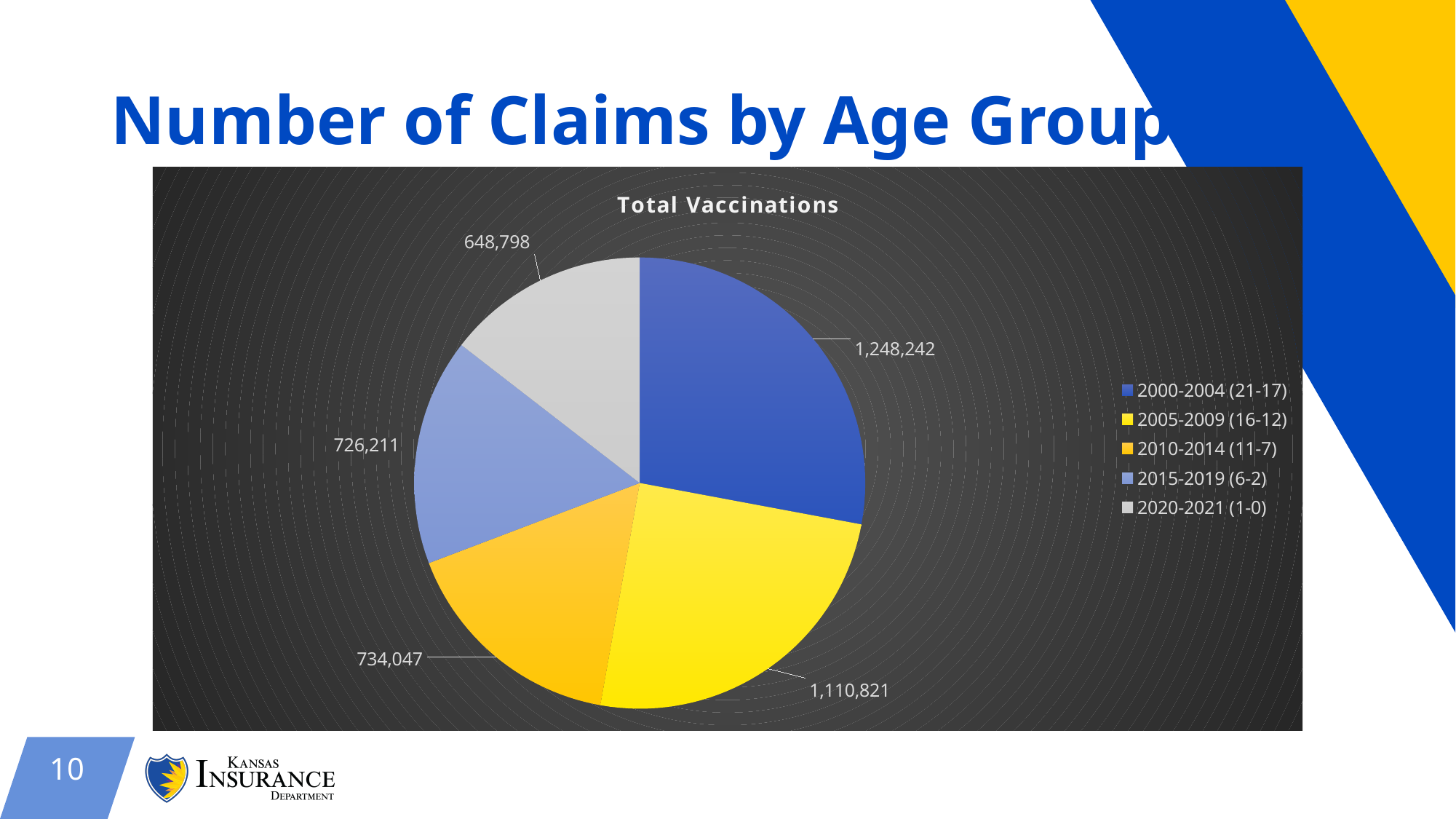
Which age group has the largest slice of the pie? 2000-2004 (21-17) What is the value for the 2020-2021 (1-0) age group? 648,798 How many age groups does the legend list? 5 What type of chart is shown on the slide? Pie chart What is the value for the 2000-2004 (21-17) age group? 1,248,242 Which is larger, the value for 2005-2009 (16-12) or the value for 2020-2021 (1-0)? 2005-2009 (16-12) What is the value for the 2010-2014 (11-7) age group? 734,047 What is the difference between the values for 2000-2004 (21-17) and 2005-2009 (16-12)? 137,421 What is the value for the 2015-2019 (6-2) age group? 726,211 What is the value for the 2005-2009 (16-12) age group? 1,110,821 Which age group has the smallest slice of the pie? 2020-2021 (1-0) What is the title of the chart? Total Vaccinations